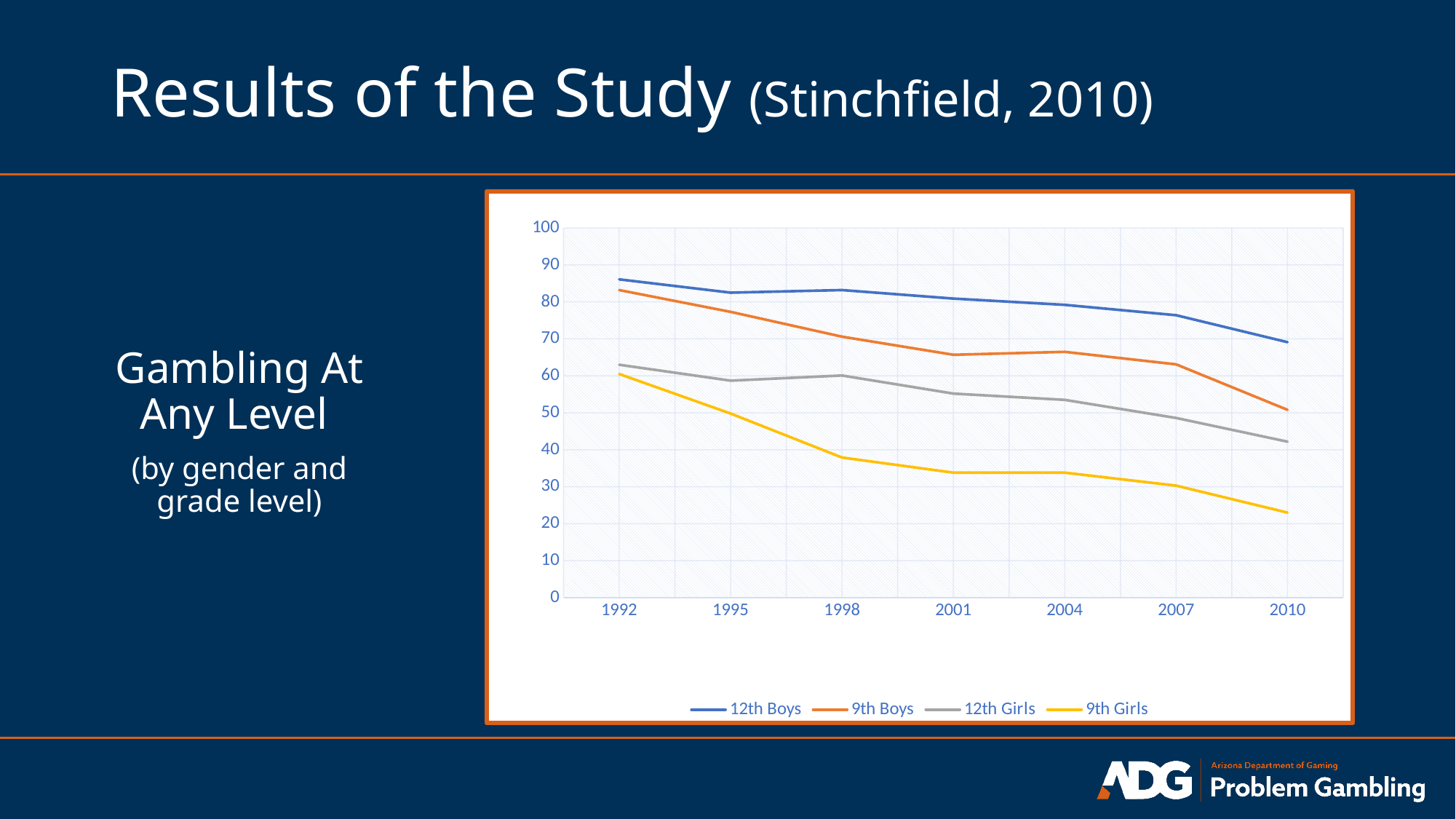
Is the value for 12th Boys in 1992 greater or less than 80? greater Is the value for 9th Girls in 2010 greater or less than 30? less How many series does the chart's legend list? 4 Is the value for 12th Girls in 2010 greater or less than 50? less Which series has the highest value in 2010? 12th Boys What kind of chart is shown on the slide? line chart How many years are shown along the x axis of the chart? 7 Which series has the lowest value in 2010? 9th Girls Do the values for 9th Girls rise or fall from 1992 to 2010? fall In 2004, which is larger: the value for 9th Boys or the value for 12th Girls? 9th Boys